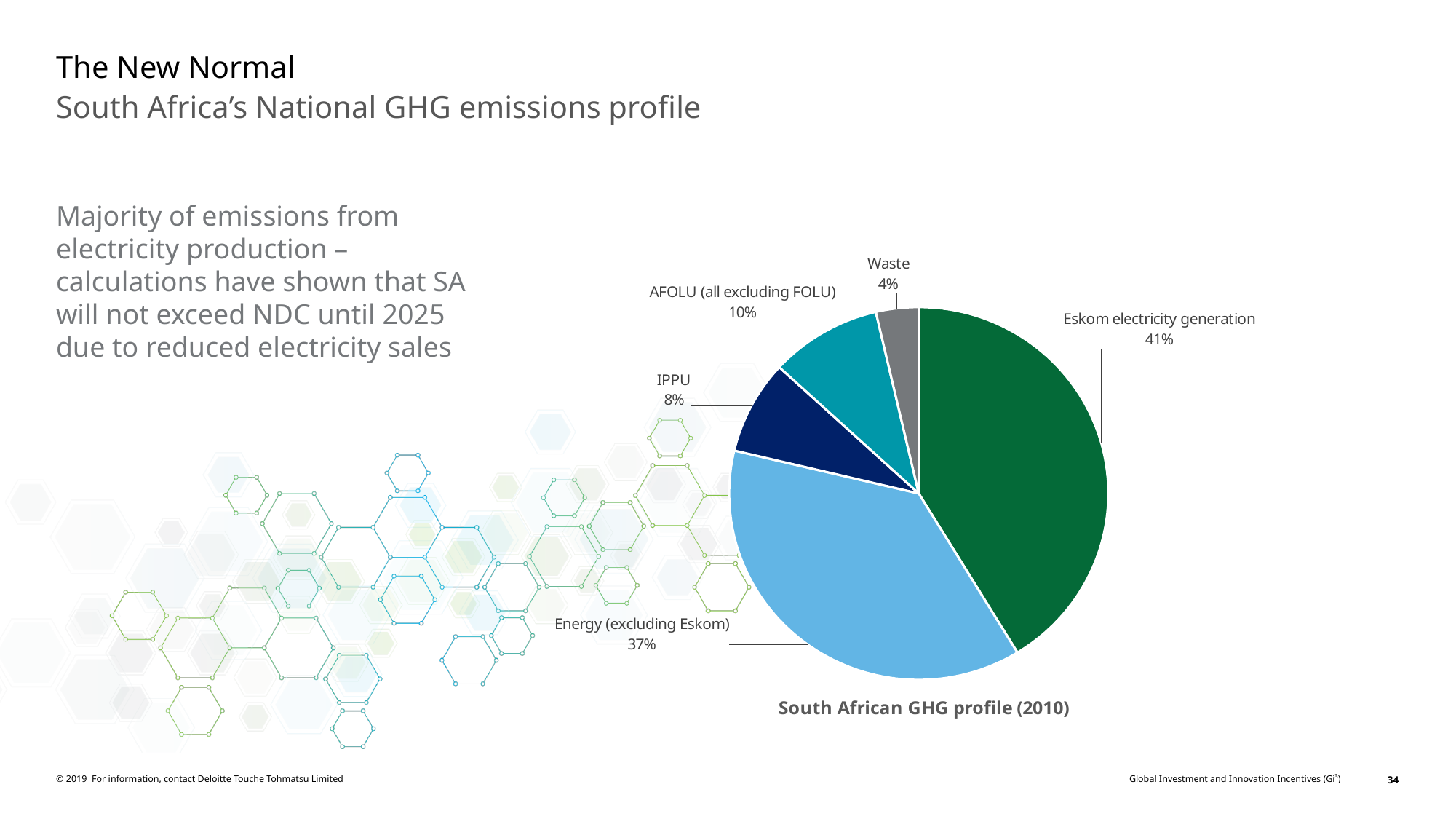
What is the value for IPPU? 8% What is the difference in percentage points between Eskom electricity generation and Energy (excluding Eskom)? 4 What share of the pie does Eskom electricity generation account for? 41% What percentage is shown for AFOLU (all excluding FOLU)? 10% Which category has the largest slice of the pie? Eskom electricity generation What percentage is shown for Energy (excluding Eskom)? 37% What kind of chart is shown on the slide? Pie chart What colour is the slice for Waste? Grey How many categories are shown in the pie chart? 5 Which is larger, the share for AFOLU (all excluding FOLU) or the share for IPPU? AFOLU (all excluding FOLU) Which category has the smallest slice of the pie? Waste What is the title of the chart? South African GHG profile (2010)